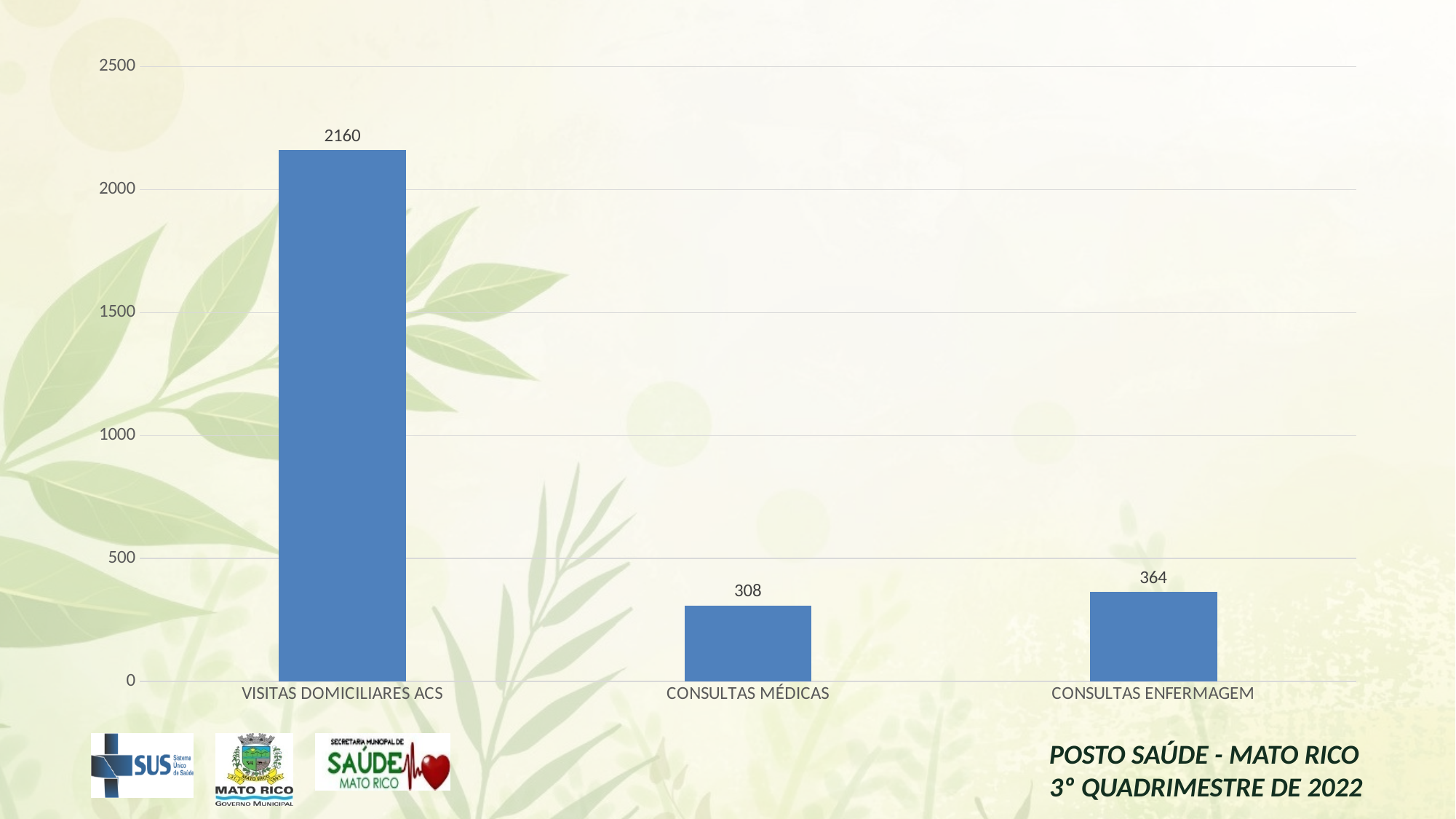
Which category has the highest value? VISITAS DOMICILIARES ACS Is the value for CONSULTAS MÉDICAS greater or less than 500? less What is the difference between VISITAS DOMICILIARES ACS and CONSULTAS ENFERMAGEM? 1796 What is the difference between CONSULTAS ENFERMAGEM and CONSULTAS MÉDICAS? 56 What is the value for CONSULTAS ENFERMAGEM? 364 How many categories are shown in the chart? 3 What is the value for CONSULTAS MÉDICAS? 308 Is the value for VISITAS DOMICILIARES ACS greater or less than 2000? greater Which category has the lowest value? CONSULTAS MÉDICAS Which is larger, CONSULTAS MÉDICAS or CONSULTAS ENFERMAGEM? CONSULTAS ENFERMAGEM What kind of chart is shown on the slide? bar chart What is the value for VISITAS DOMICILIARES ACS? 2160